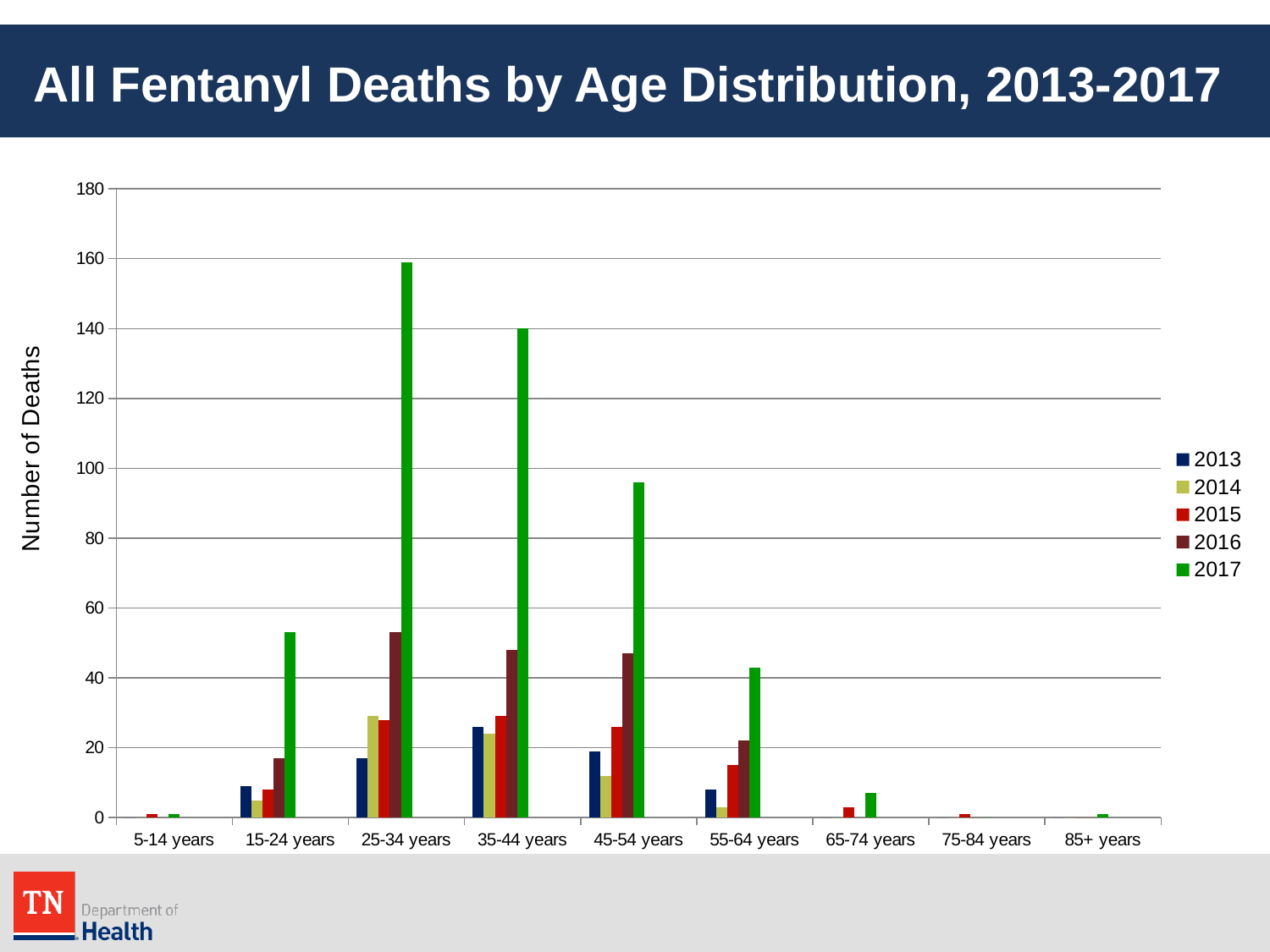
Is the 2017 value for 25-34 years greater or less than 140? greater Which age group has the highest number of deaths for 2017? 25-34 years Is the 2017 value for 55-64 years greater or less than 60? less What is the label on the vertical axis of the chart? Number of Deaths How many age groups are shown on the x axis? 9 What kind of chart is shown on the slide? bar chart Which is larger, the 2016 value for 25-34 years or the 2016 value for 55-64 years? 25-34 years Is the 2017 value for 45-54 years greater or less than 80? greater Do the 2017 values rise or fall along the x axis from 25-34 years to 85+ years? fall How many series does the legend list? 5 Which is larger, the 2017 value for 15-24 years or the 2017 value for 55-64 years? 15-24 years